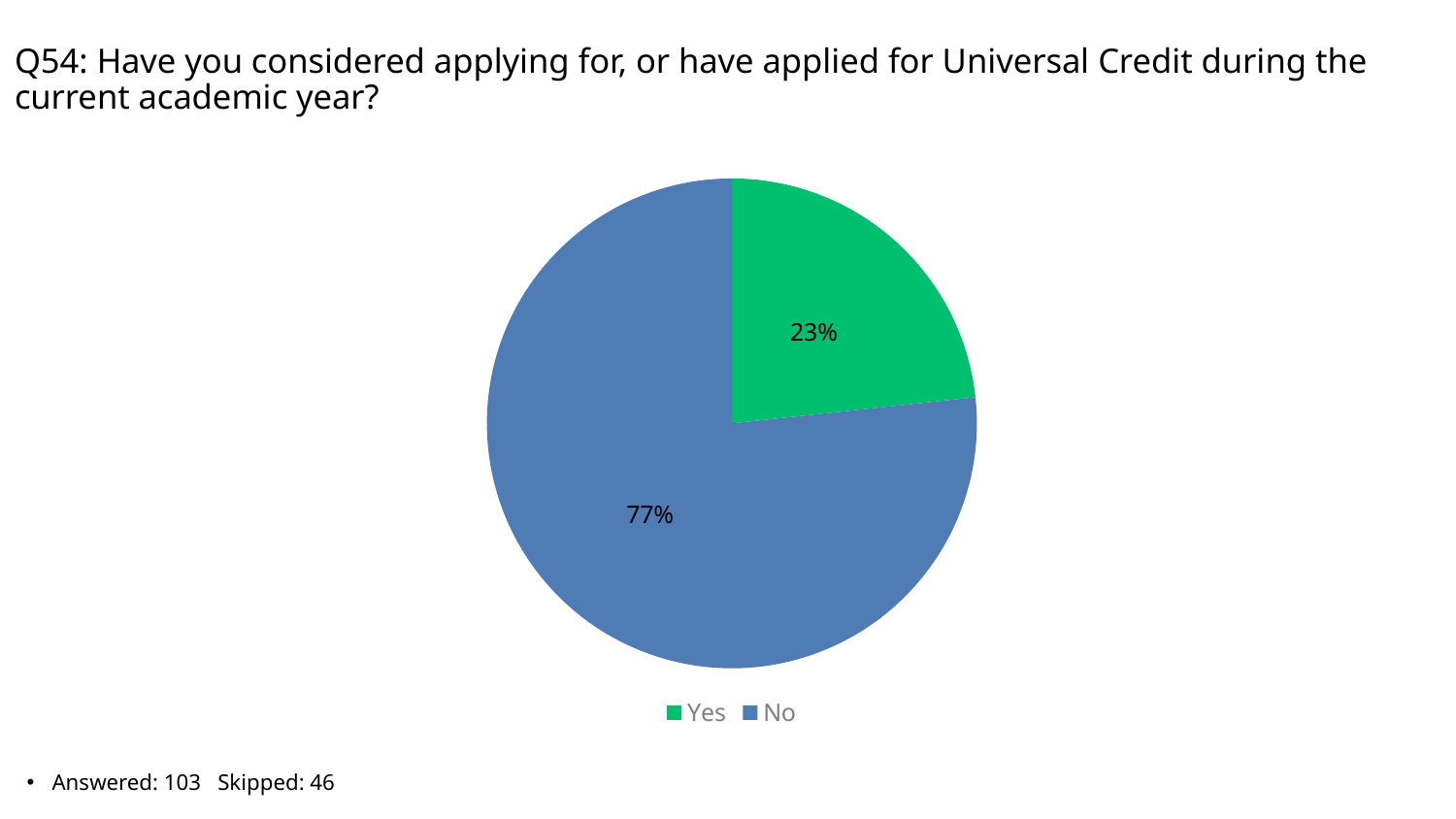
What is the difference in percentage points between the "No" and "Yes" slices? 54 What share of the pie does the "No" slice represent? 77% Which is larger, the "Yes" slice or the "No" slice? No What kind of chart is shown on the slide? pie chart How many respondents answered the question according to the slide? 103 What percentage of respondents answered "Yes"? 23% How many slices does the pie chart have? 2 Which response has the largest share of the pie? No What percentage of respondents answered "No"? 77% How many entries does the legend list? 2 Which response has the smallest share of the pie? Yes What colour is the "Yes" slice? green